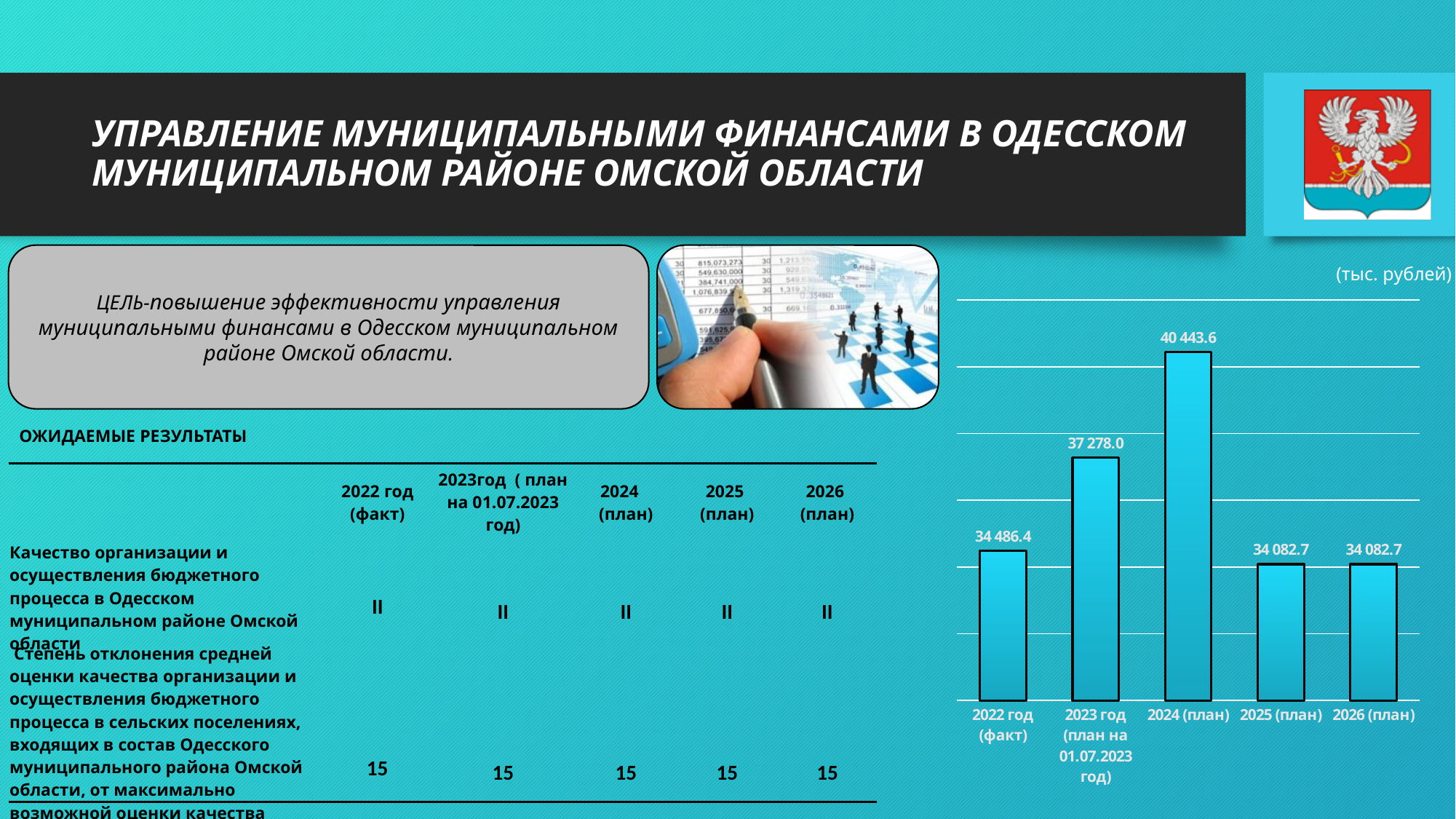
In what units are the values on the bar chart expressed? тыс. рублей What is the value for 2023 год (план на 01.07.2023 год) on the bar chart? 37 278.0 Which is larger on the bar chart: the value for 2022 год (факт) or the value for 2025 (план)? 2022 год (факт) What is the value for 2022 год (факт) on the bar chart? 34 486.4 What kind of chart is shown on the right side of the slide? Bar chart What is the difference between the values for 2024 (план) and 2023 год (план на 01.07.2023 год)? 3 165.6 What is the value for 2026 (план) on the bar chart? 34 082.7 What is the difference between the values for 2023 год (план на 01.07.2023 год) and 2022 год (факт)? 2 791.6 How many categories are shown on the bar chart? 5 Which category has the highest value on the bar chart? 2024 (план) What is the value for 2024 (план) on the bar chart? 40 443.6 What is the lowest value shown on the bar chart? 34 082.7